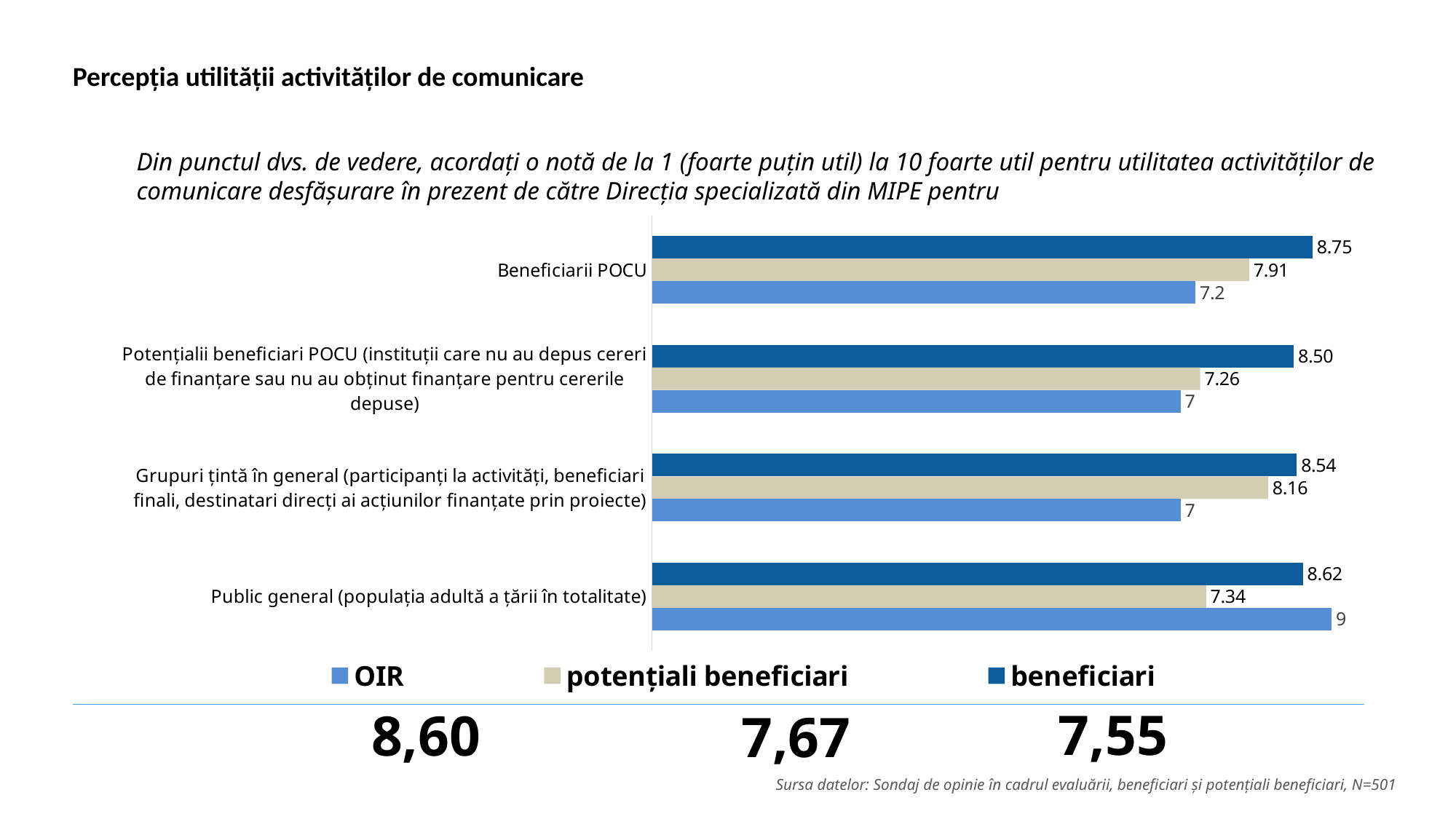
How many series does the legend list? 3 Which category has the lowest value in the beneficiari series? Potențialii beneficiari POCU What value does the potențiali beneficiari series show for Grupuri țintă în general? 8.16 What is the difference between the beneficiari value and the OIR value for Beneficiarii POCU? 1.55 Which series is shown in dark blue in the legend? beneficiari Which category has the highest value in the potențiali beneficiari series? Grupuri țintă în general What value does the OIR series show for Public general (populația adultă a țării în totalitate)? 9 For Public general, which is larger: the OIR value or the beneficiari value? OIR What value does the OIR series show for Potențialii beneficiari POCU? 7 How many categories are shown on the chart? 4 What value does the beneficiari series show for Beneficiarii POCU? 8.75 What kind of chart is shown on the slide? Bar chart